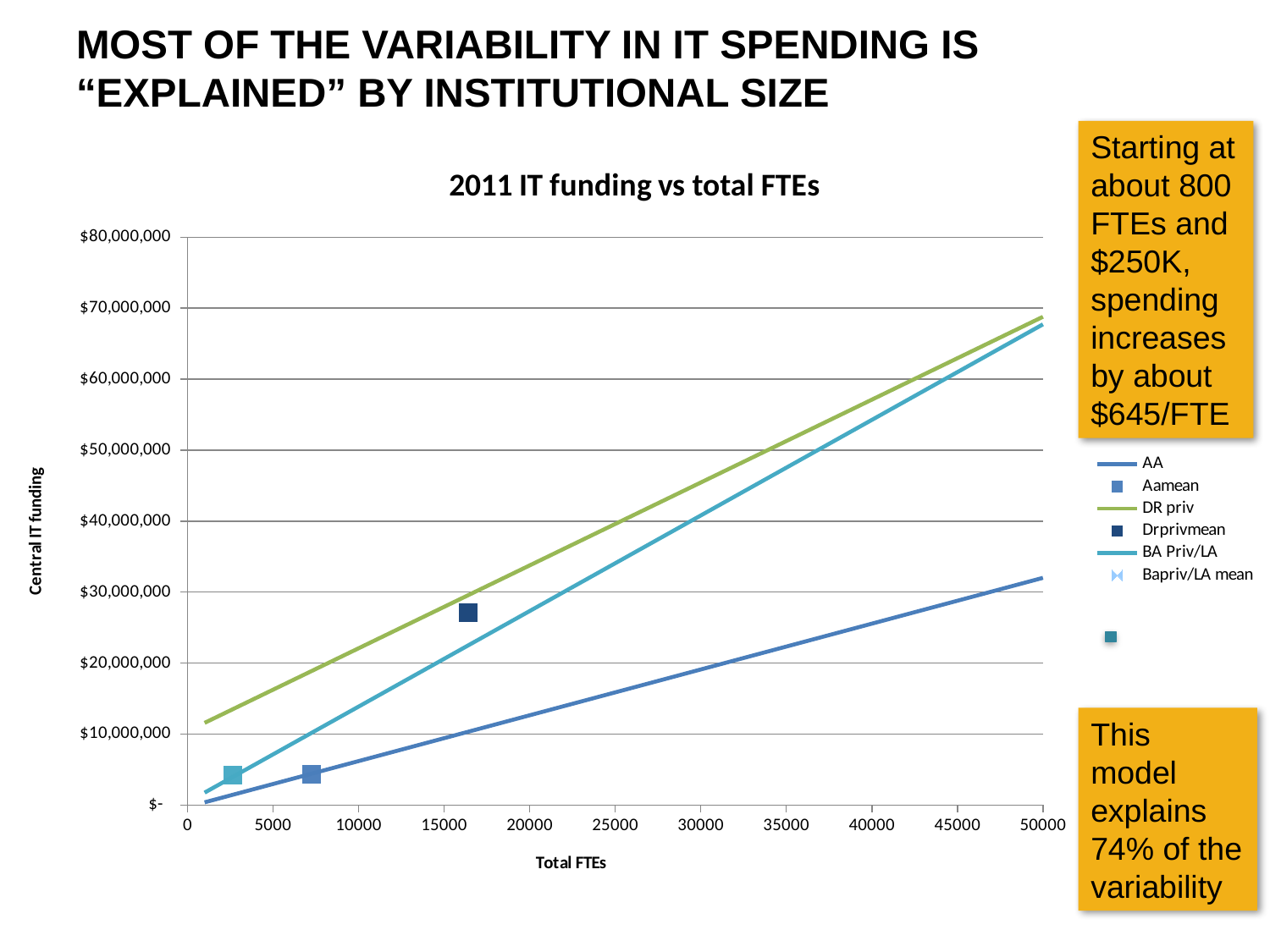
Is the value of the AA line at 50000 Total FTEs greater or less than $40,000,000? less What is the title of the chart? 2011 IT funding vs total FTEs Is the Drprivmean marker greater or less than $30,000,000 in Central IT funding? less Which line has the lowest Central IT funding at 50000 Total FTEs? AA Which marker shows higher Central IT funding, Drprivmean or Aamean? Drprivmean What type of chart is shown on the slide? line chart Which is larger at 50000 Total FTEs, the DR priv line or the AA line? DR priv What is the label of the x axis? Total FTEs Do the AA, DR priv and BA Priv/LA lines rise or fall as Total FTEs increases? rise Is the Aamean marker greater or less than $10,000,000 in Central IT funding? less How many series does the chart legend list? 6